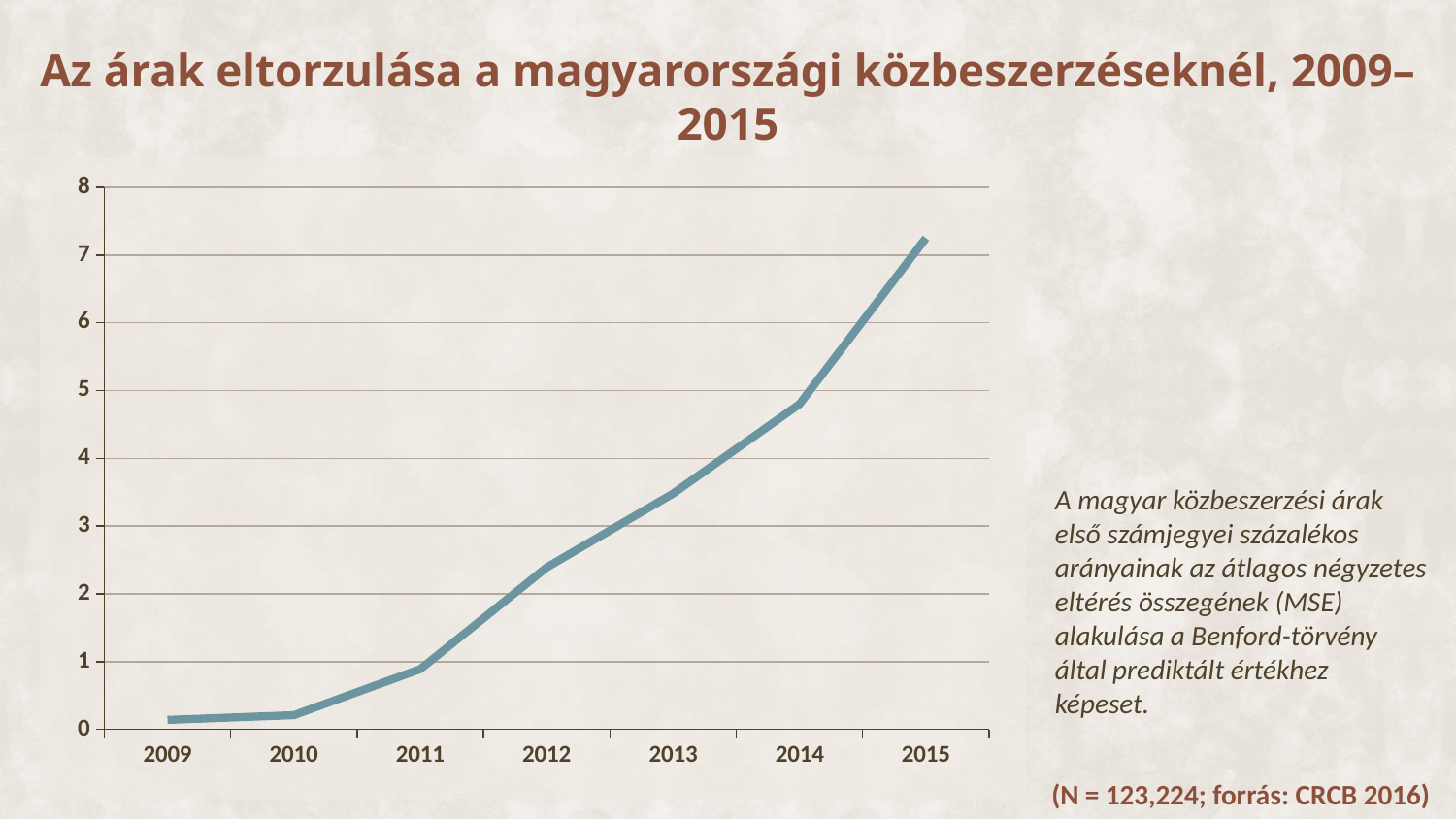
Is the value for 2013 greater or less than 3? greater What is the highest value shown on the y axis? 8 Which year has the highest value? 2015 Is the value for 2015 greater or less than 7? greater Do the values rise or fall from 2009 to 2015? rise What is the title of the chart on the slide? Az árak eltorzulása a magyarországi közbeszerzéseknél, 2009–2015 Is the value for 2012 greater or less than 2? greater How many years are plotted along the x axis? 7 Which is larger, the value for 2013 or the value for 2014? 2014 What kind of chart is shown on the slide? line chart